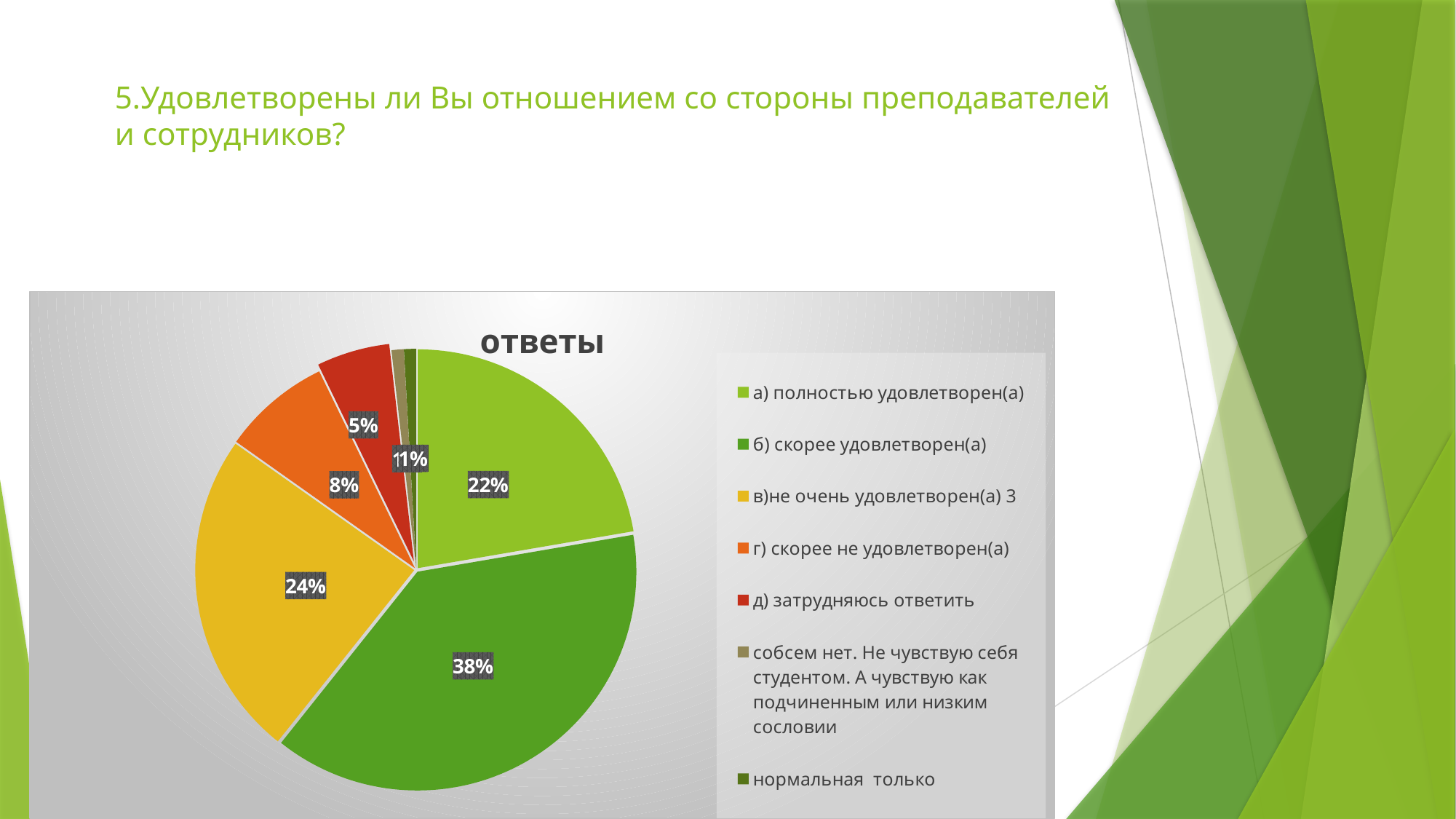
How many entries does the legend list? 7 What share of the pie is labelled for "д) затрудняюсь ответить"? 5% What share of the pie is labelled for "г) скорее не удовлетворен(а)"? 8% By how many percentage points does "б) скорее удовлетворен(а)" exceed "а) полностью удовлетворен(а)"? 16 percentage points What share of the pie is labelled for "а) полностью удовлетворен(а)"? 22% What kind of chart is shown on the slide? pie chart Which answer option has the largest slice of the pie? б) скорее удовлетворен(а) What share of the pie is labelled for "в)не очень удовлетворен(а)"? 24% What share of the pie is labelled for "б) скорее удовлетворен(а)"? 38% Which slice is larger: "в)не очень удовлетворен(а)" or "г) скорее не удовлетворен(а)"? в)не очень удовлетворен(а) What is the title of the chart? ответы What is the difference between the shares for "в)не очень удовлетворен(а)" and "г) скорее не удовлетворен(а)"? 16 percentage points